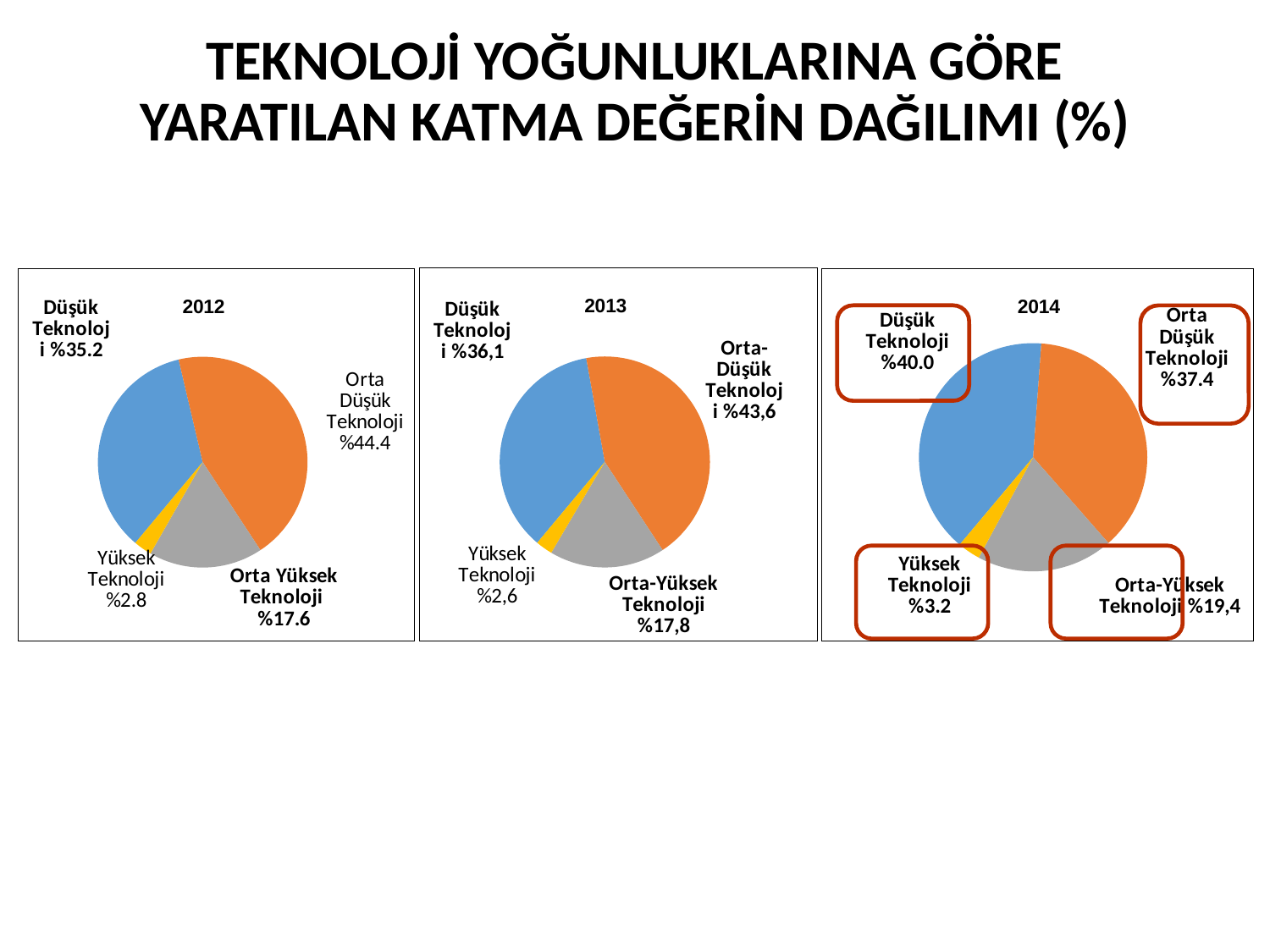
In the 2013 pie chart, which category has the smallest share? Yüksek Teknoloji In the 2012 pie chart, what is the share for Yüksek Teknoloji? %2.8 In the 2014 pie chart, what is the difference between the shares of Düşük Teknoloji and Orta Düşük Teknoloji? 2.6 How many slices does the 2014 pie chart have? 4 In the 2012 pie chart, which category has the largest share? Orta Düşük Teknoloji In the 2014 pie chart, which category has the largest share? Düşük Teknoloji In the 2014 pie chart, what is the share for Orta-Yüksek Teknoloji? %19,4 In the 2012 pie chart, what is the share for Orta Düşük Teknoloji? %44.4 In the 2013 pie chart, which is larger: Düşük Teknoloji or Orta-Düşük Teknoloji? Orta-Düşük Teknoloji In the 2013 pie chart, what is the share for Orta-Yüksek Teknoloji? %17,8 What type of chart is used for the 2012 data? pie chart In the 2013 pie chart, what is the share for Düşük Teknoloji? %36,1